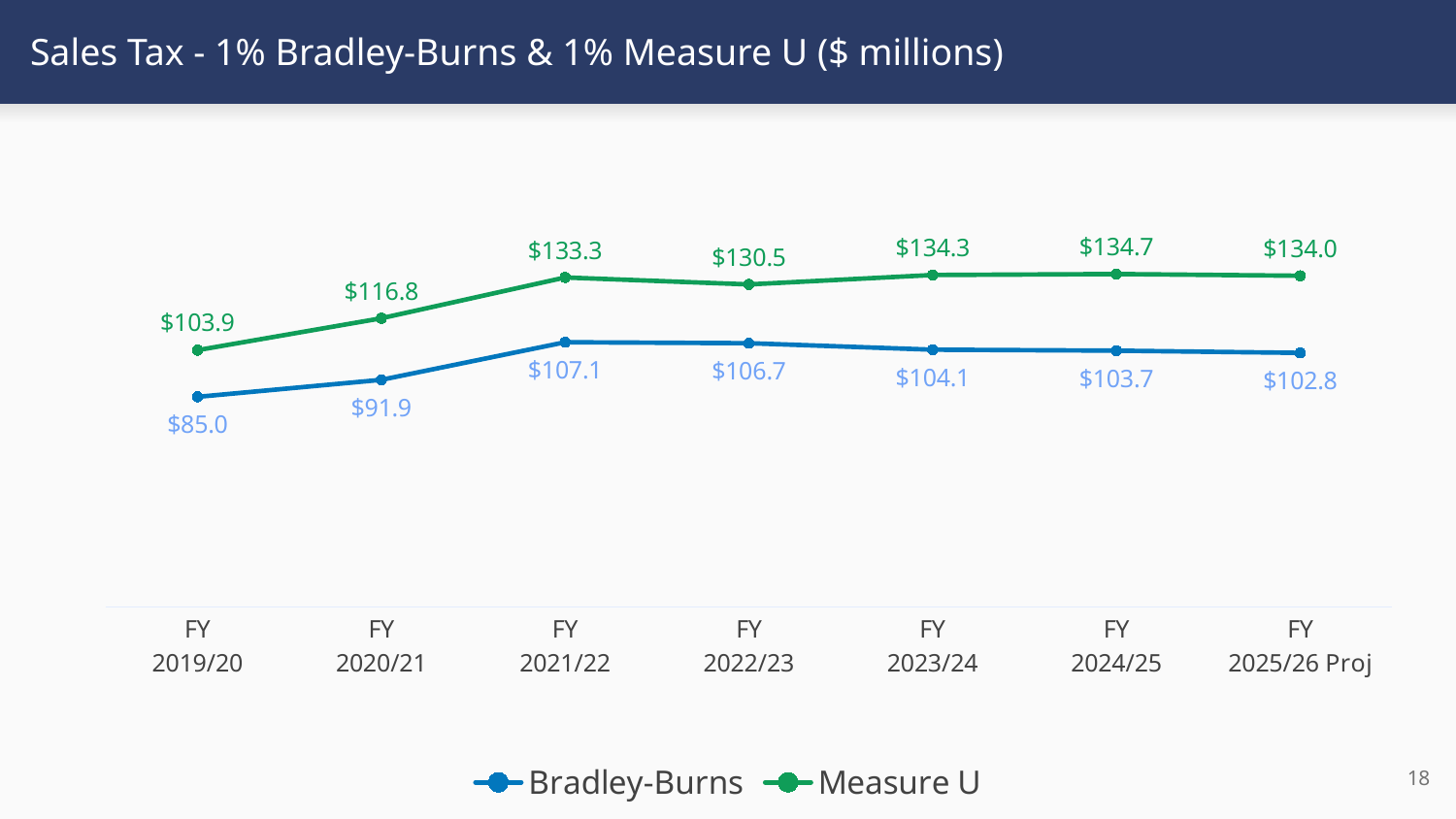
How many series does the legend list? 2 How many fiscal years are plotted on the x axis? 7 What colour is the Measure U line? Green Does the Bradley-Burns series rise or fall from FY 2021/22 to FY 2025/26 Proj? Fall Which is larger: the Bradley-Burns value for FY 2020/21 or for FY 2022/23? FY 2022/23 What is the Bradley-Burns value for FY 2019/20? $85.0 What is the difference between the Measure U and Bradley-Burns values in FY 2021/22? $26.2 In which fiscal year is the Measure U value highest? FY 2024/25 What kind of chart is shown on the slide? Line chart What is the Measure U value for FY 2024/25? $134.7 In which fiscal year is the Bradley-Burns value lowest? FY 2019/20 What is the Bradley-Burns value for FY 2025/26 Proj? $102.8